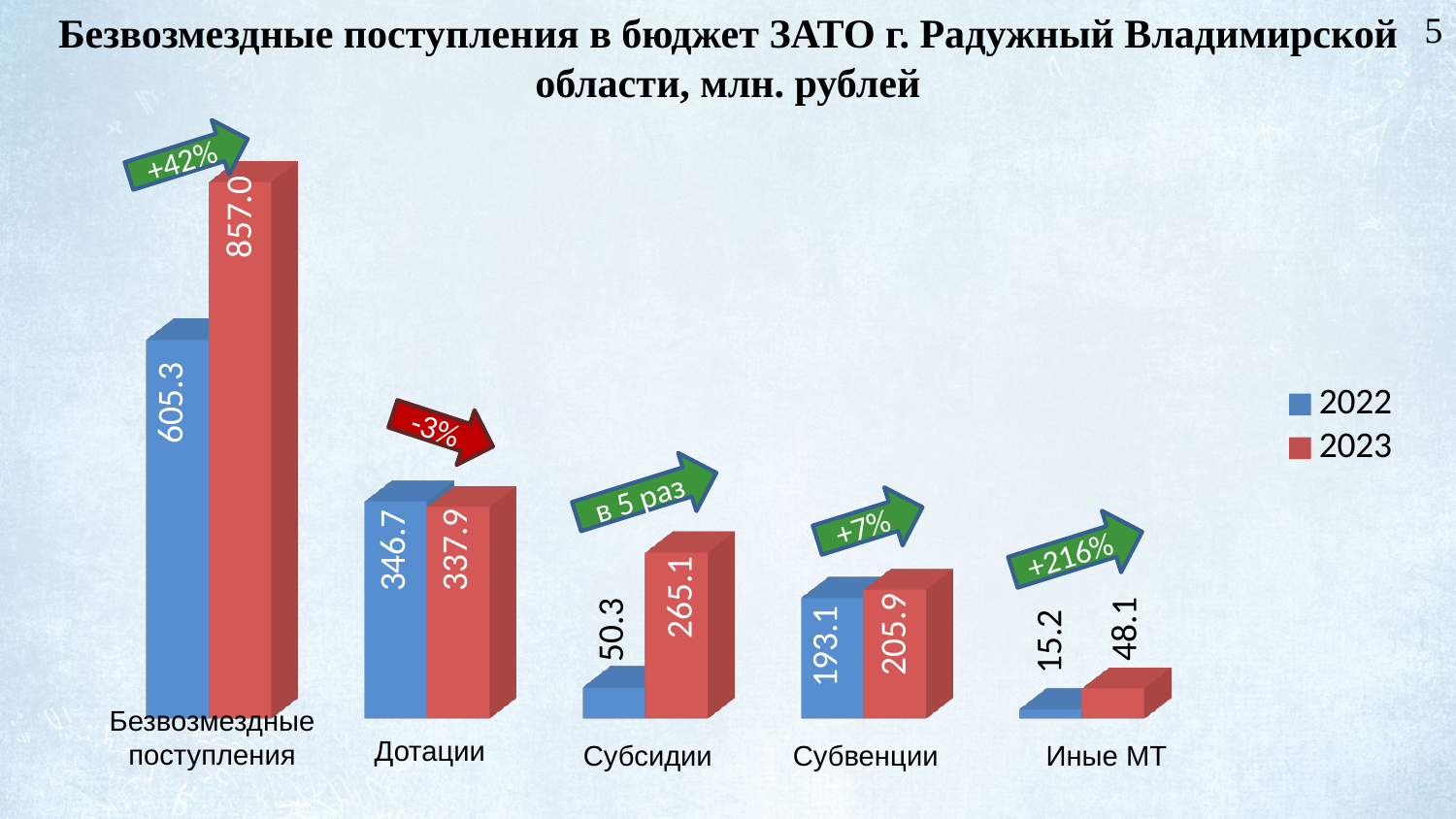
Which category has the lowest value in 2022? Иные МТ What is the difference between the 2023 and 2022 values for Безвозмездные поступления? 251.7 Which category has the highest value in 2023? Безвозмездные поступления What is the value for Дотации in 2022? 346.7 How many series does the legend list? 2 Which is larger for Дотации: the 2022 value or the 2023 value? 2022 What is the value for Иные МТ in 2022? 15.2 What is the value for Субсидии in 2023? 265.1 How many categories are shown on the x axis? 5 What kind of chart is shown on the slide? Bar chart What percentage change is shown by the arrow above Иные МТ? +216% What is the difference between the 2023 and 2022 values for Субсидии? 214.8